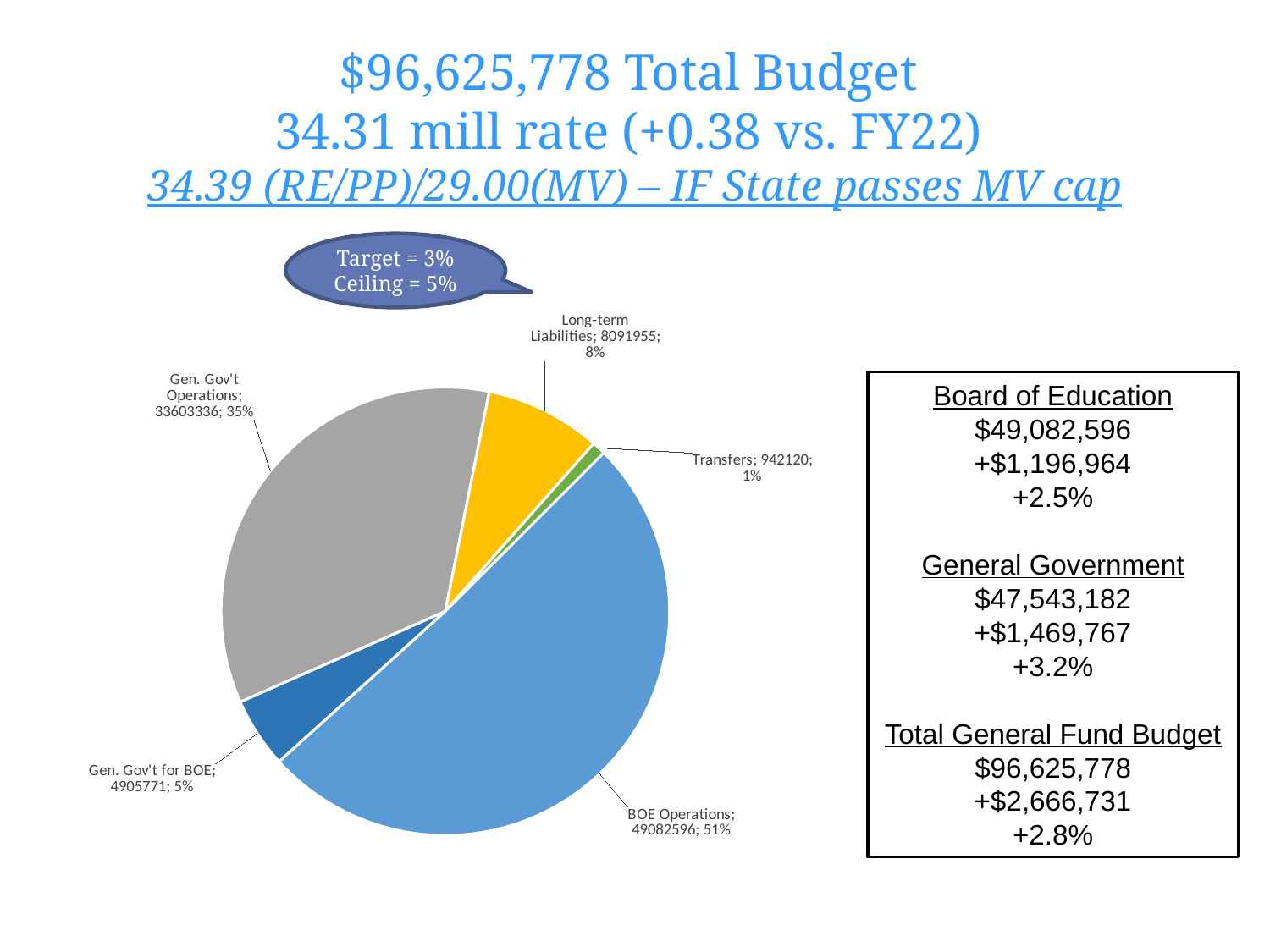
What kind of chart is shown on the slide? pie chart What is the difference between the BOE Operations value and the Gen. Gov't Operations value? 15479260 What is the value shown for Gen. Gov't Operations in the pie chart? 33603336 What share of the pie does BOE Operations represent? 51% What share of the pie does Gen. Gov't for BOE represent? 5% Which slice of the pie chart is the largest? BOE Operations What is the value shown for BOE Operations in the pie chart? 49082596 Which slice of the pie chart is the smallest? Transfers What is the value shown for Long-term Liabilities in the pie chart? 8091955 How many slices does the pie chart have? 5 What is the value shown for Transfers in the pie chart? 942120 Which is larger, Long-term Liabilities or Gen. Gov't for BOE? Long-term Liabilities